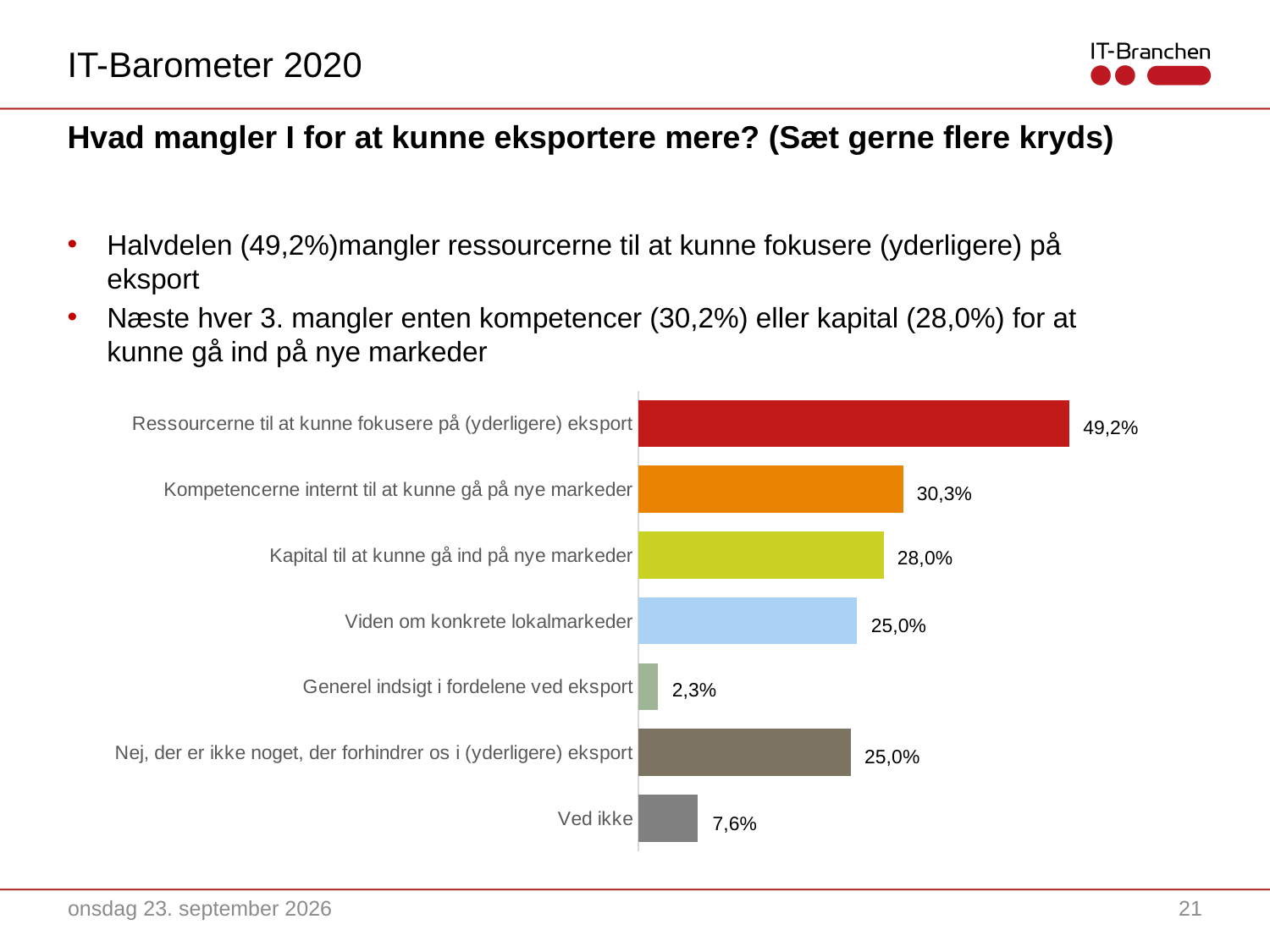
What is the value for "Ressourcerne til at kunne fokusere på (yderligere) eksport"? 49,2% Which category has the highest value? Ressourcerne til at kunne fokusere på (yderligere) eksport What colour is the bar for "Ressourcerne til at kunne fokusere på (yderligere) eksport"? Red What is the value for "Kapital til at kunne gå ind på nye markeder"? 28,0% Which is larger: the value for "Kapital til at kunne gå ind på nye markeder" or the value for "Viden om konkrete lokalmarkeder"? Kapital til at kunne gå ind på nye markeder What kind of chart is shown on the slide? Bar chart What is the difference between the values for "Ressourcerne til at kunne fokusere på (yderligere) eksport" and "Kompetencerne internt til at kunne gå på nye markeder"? 18,9% What is the value for "Kompetencerne internt til at kunne gå på nye markeder"? 30,3% What is the value for "Ved ikke"? 7,6% How many categories are shown in the chart? 7 Which category has the lowest value? Generel indsigt i fordelene ved eksport What is the difference between the values for "Ved ikke" and "Generel indsigt i fordelene ved eksport"? 5,3%